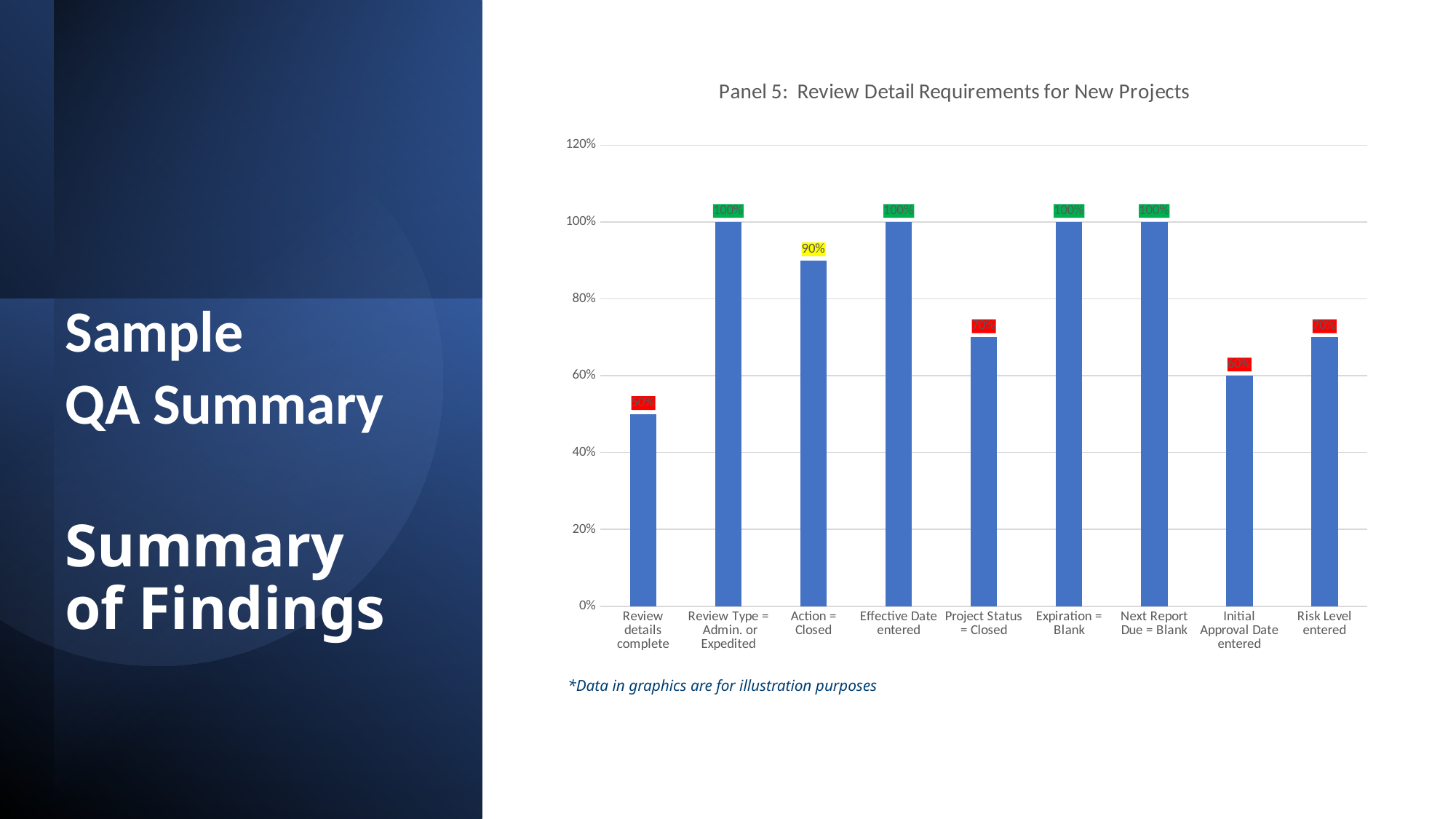
Is the value for Review details complete greater or less than 60%? less Is the value for Risk Level entered greater or less than 80%? less What kind of chart is shown? bar chart Is the value for Project Status = Closed greater or less than 60%? greater What is the title of the chart? Panel 5: Review Detail Requirements for New Projects Which is larger, the value for Action = Closed or the value for Initial Approval Date entered? Action = Closed What is the value for Review Type = Admin. or Expedited? 100% What is the difference between the value for Effective Date entered and the value for Action = Closed? 10% How many categories are shown on the x axis? 9 What is the value for Action = Closed? 90% Which category has the lowest value? Review details complete What is the value for Initial Approval Date entered? 60%